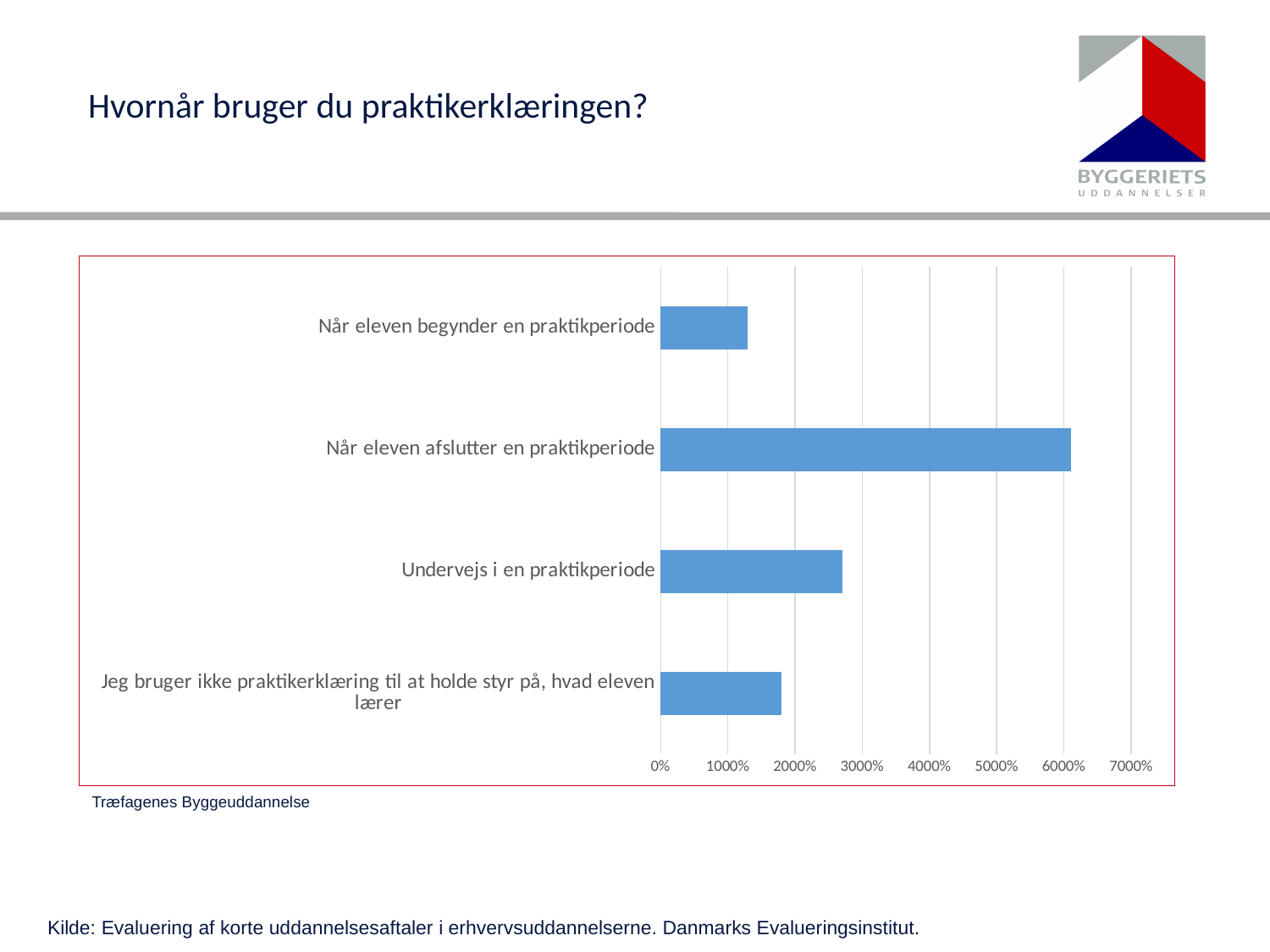
Is the value for 'Når eleven afslutter en praktikperiode' greater or less than 5000%? greater Which is larger: the value for 'Når eleven afslutter en praktikperiode' or the value for 'Jeg bruger ikke praktikerklæring til at holde styr på, hvad eleven lærer'? Når eleven afslutter en praktikperiode Is the value for 'Når eleven begynder en praktikperiode' greater or less than 2000%? less Which category has the highest value in the chart? Når eleven afslutter en praktikperiode What is the title of the slide containing the chart? Hvornår bruger du praktikerklæringen? What is the highest value shown on the chart's horizontal axis? 7000% Is the value for 'Undervejs i en praktikperiode' greater or less than 2000%? greater Which category has the lowest value in the chart? Når eleven begynder en praktikperiode Which is larger: the value for 'Undervejs i en praktikperiode' or the value for 'Når eleven begynder en praktikperiode'? Undervejs i en praktikperiode How many categories are shown in the chart? 4 What kind of chart is shown on the slide? bar chart